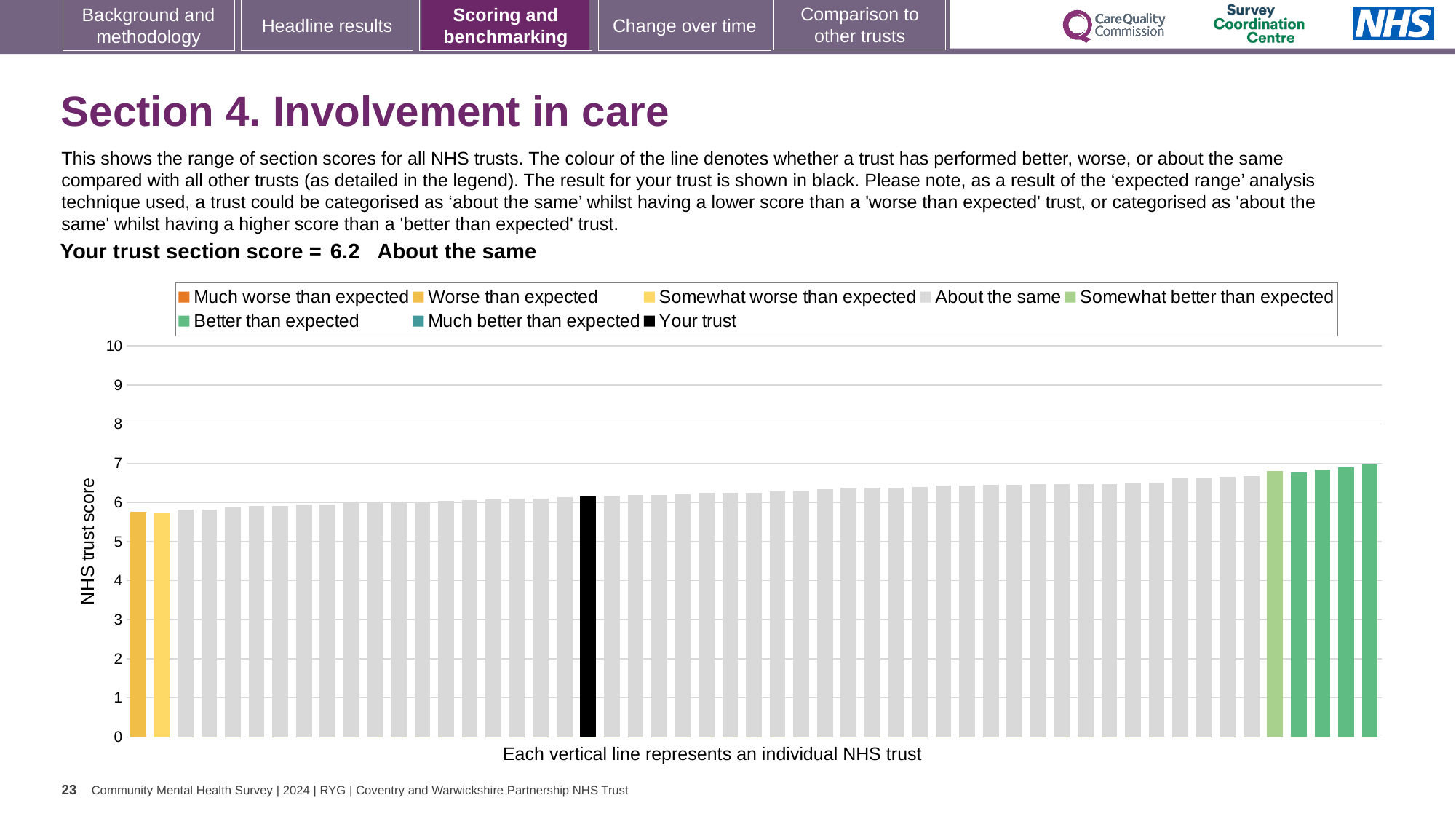
What kind of chart is shown on the slide? Bar chart What is the section score for your trust shown on the slide? 6.2 Is the value of the black bar (your trust) greater or less than 5? greater Do the bar values rise or fall from left to right across the chart? Rise How many bars are coloured green in the chart? 5 How many entries does the chart legend list? 8 Which category is your trust's section score placed in? About the same Which is larger, the value of the black bar or the value of the leftmost bar? The black bar Which bar is the highest in the chart, the leftmost or the rightmost? Rightmost What is the label on the vertical axis of the chart? NHS trust score Is the value of the rightmost bar greater or less than 6? greater Is the value of the leftmost bar greater or less than 6? less